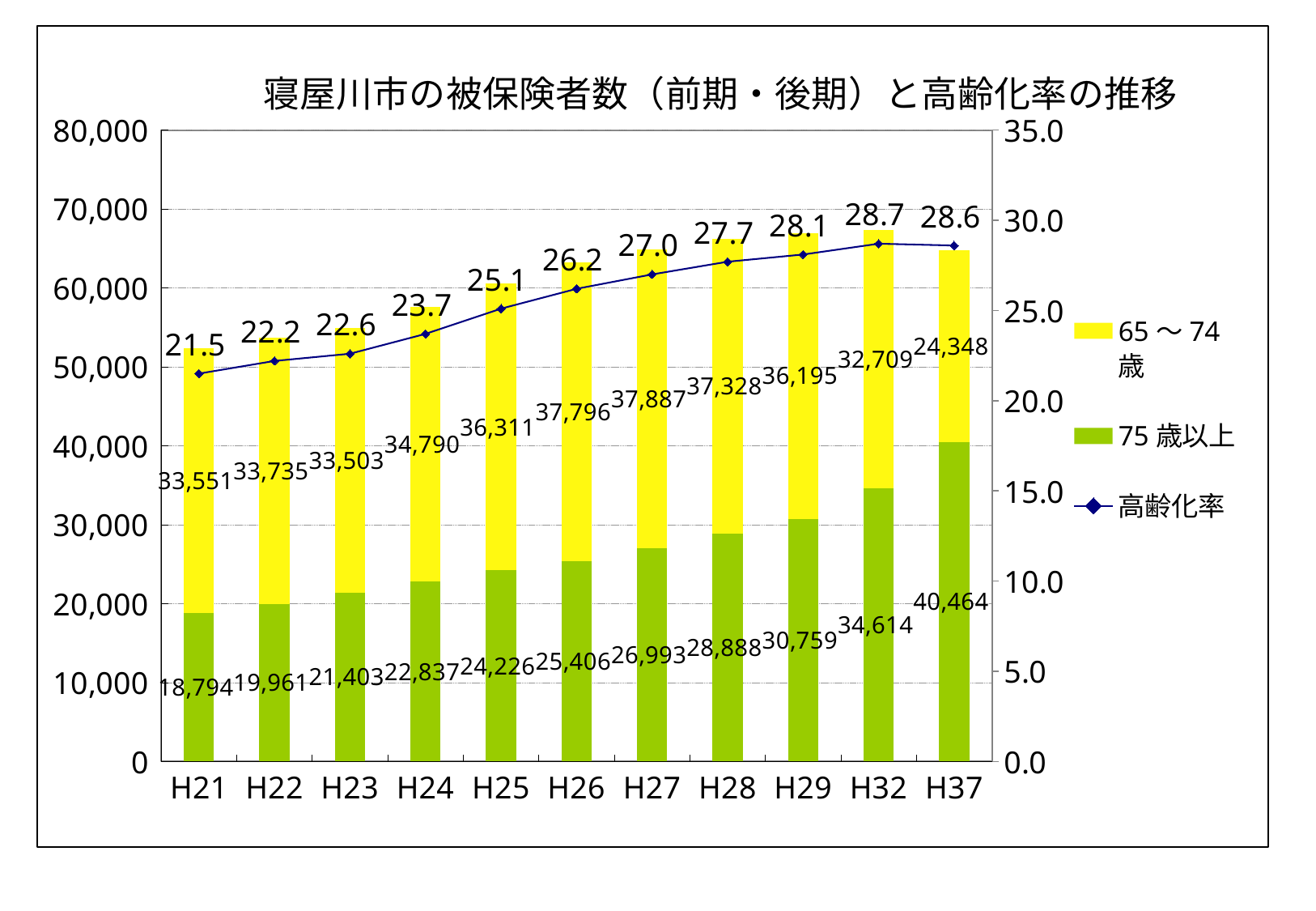
What is the value of 75歳以上 for H21? 18,794 What is the 高齢化率 value for H25? 25.1 What is the difference between the 75歳以上 values for H37 and H32? 5,850 Which category has the lowest 高齢化率 value? H21 Does the 75歳以上 value rise or fall from H21 to H37? Rise How many series does the legend list? 3 What is the value of 65～74歳 for H27? 37,887 Which is larger, the 65～74歳 value for H26 or for H29? H26 How many categories are shown on the x axis? 11 Which category has the highest 75歳以上 value? H37 What kind of chart is this? Stacked bar chart with a line What is the total of the stacked bar for H21? 52,345